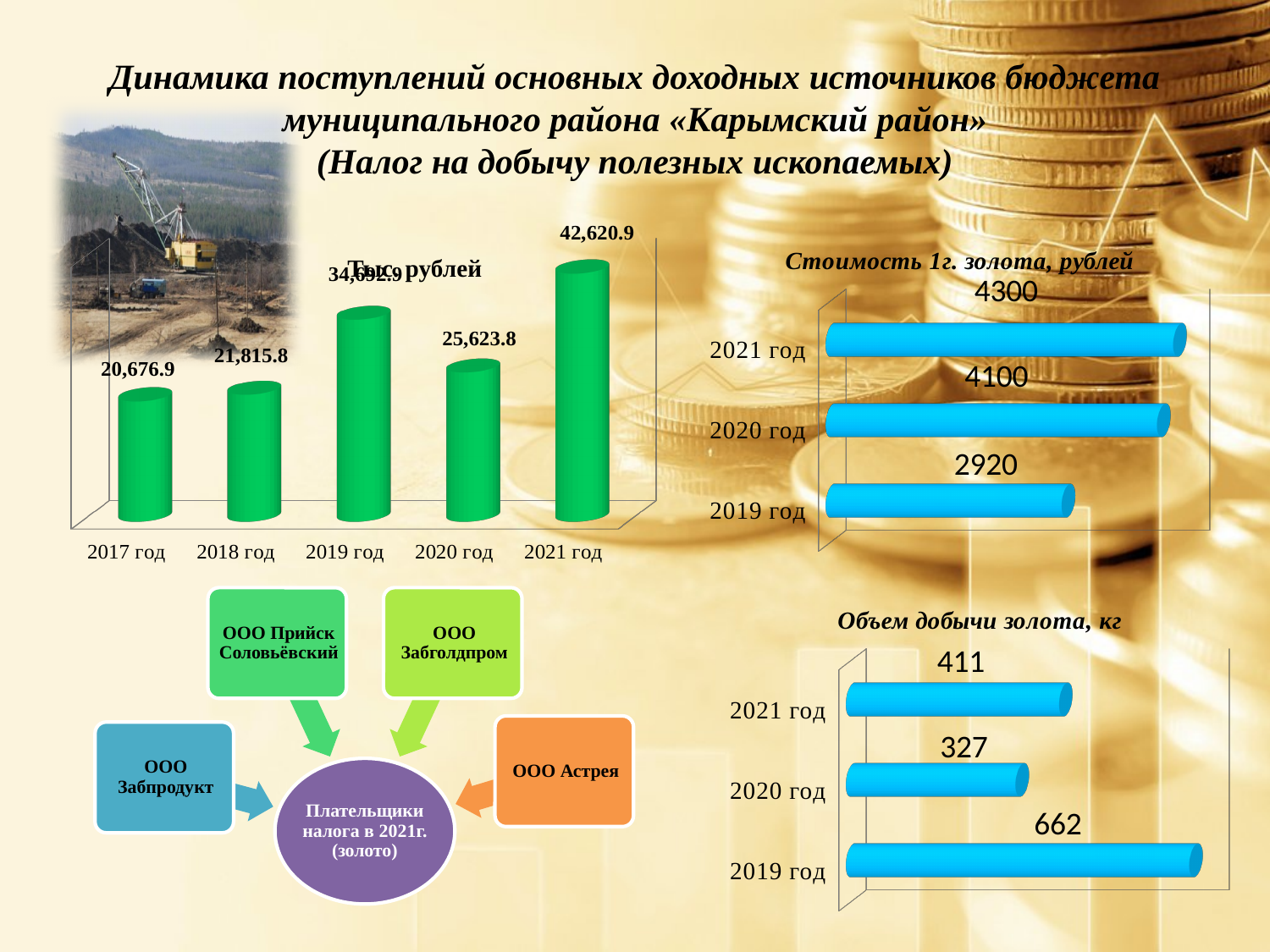
In the 'Тыс. рублей' bar chart, how many years are shown on the x axis? 5 In the 'Тыс. рублей' bar chart, which year has the lowest value? 2017 год In the 'Тыс. рублей' bar chart, which year has the highest value? 2021 год In the 'Тыс. рублей' bar chart, what is the value for 2021 год? 42,620.9 In the 'Тыс. рублей' bar chart, what is the difference between the values for 2020 год and 2018 год? 3,808.0 In the 'Стоимость 1г. золота, рублей' chart, what is the value for 2020 год? 4100 In the 'Объем добычи золота, кг' chart, what is the value for 2021 год? 411 In the 'Объем добычи золота, кг' chart, which year has the highest value? 2019 год In the 'Тыс. рублей' bar chart, what is the value for 2017 год? 20,676.9 What type of chart is the 'Объем добычи золота, кг' chart? Bar chart In the 'Стоимость 1г. золота, рублей' chart, what is the difference between the values for 2021 год and 2019 год? 1380 In the 'Стоимость 1г. золота, рублей' chart, which year has the lowest value? 2019 год